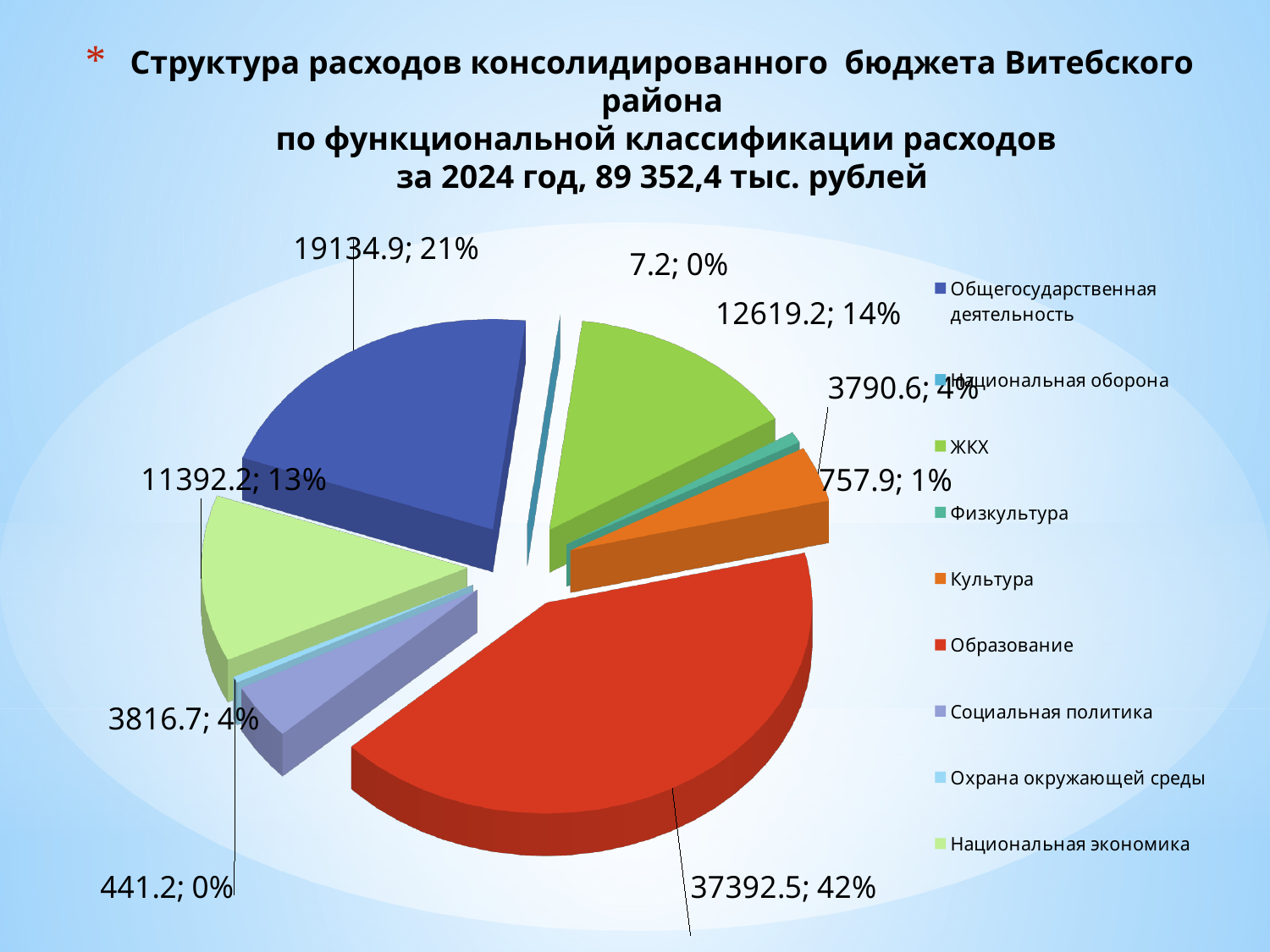
What value is shown for Национальная экономика? 11392.2 What value is shown for Образование in the pie chart? 37392.5 What percentage of the pie is Общегосударственная деятельность? 21% What share of the pie does Образование account for? 42% What kind of chart is shown on the slide? pie chart What is the difference between the values for Образование and Общегосударственная деятельность? 18257.6 What value is shown for ЖКХ in the pie chart? 12619.2 How many categories does the legend of the pie chart list? 9 Which category has the largest slice of the pie? Образование What value is shown for Общегосударственная деятельность? 19134.9 Which is larger, the value for Образование or the value for Общегосударственная деятельность? Образование Which category has the smallest value in the pie chart? Национальная оборона